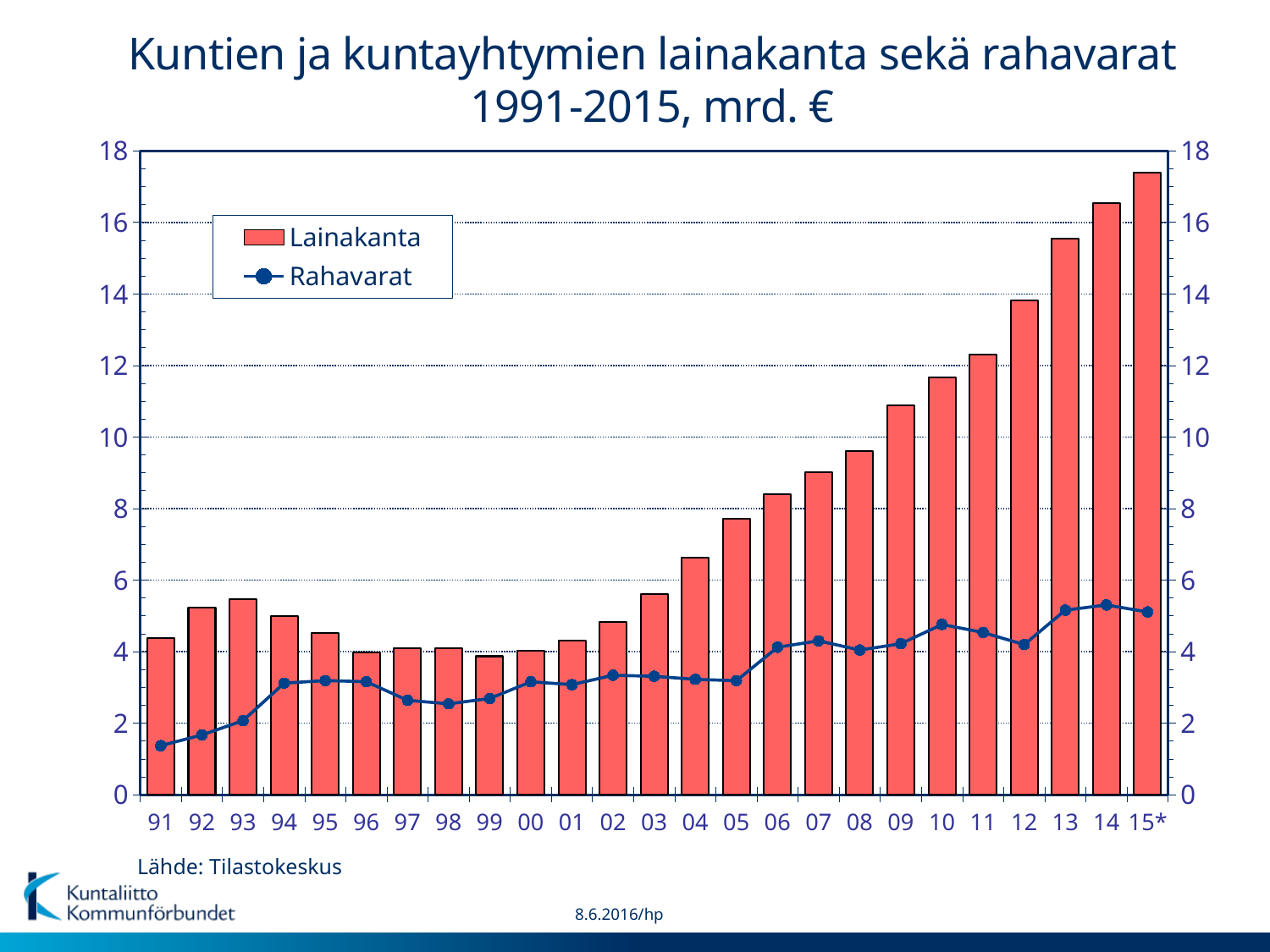
Is the Rahavarat value for 91 greater or less than 2? less Is the Lainakanta value for 15* greater or less than 16? greater How many years are shown on the x axis? 25 Is the Rahavarat value for 10 greater or less than 4? greater Which is larger, the Lainakanta value for 12 or for 13? 13 Which year has the highest Lainakanta bar? 15* How many series does the legend list? 2 What are the two series named in the legend? Lainakanta and Rahavarat Do the Lainakanta values rise or fall from 05 to 15*? rise Which year has the lowest Rahavarat value? 91 Which is larger, the Rahavarat value for 93 or for 94? 94